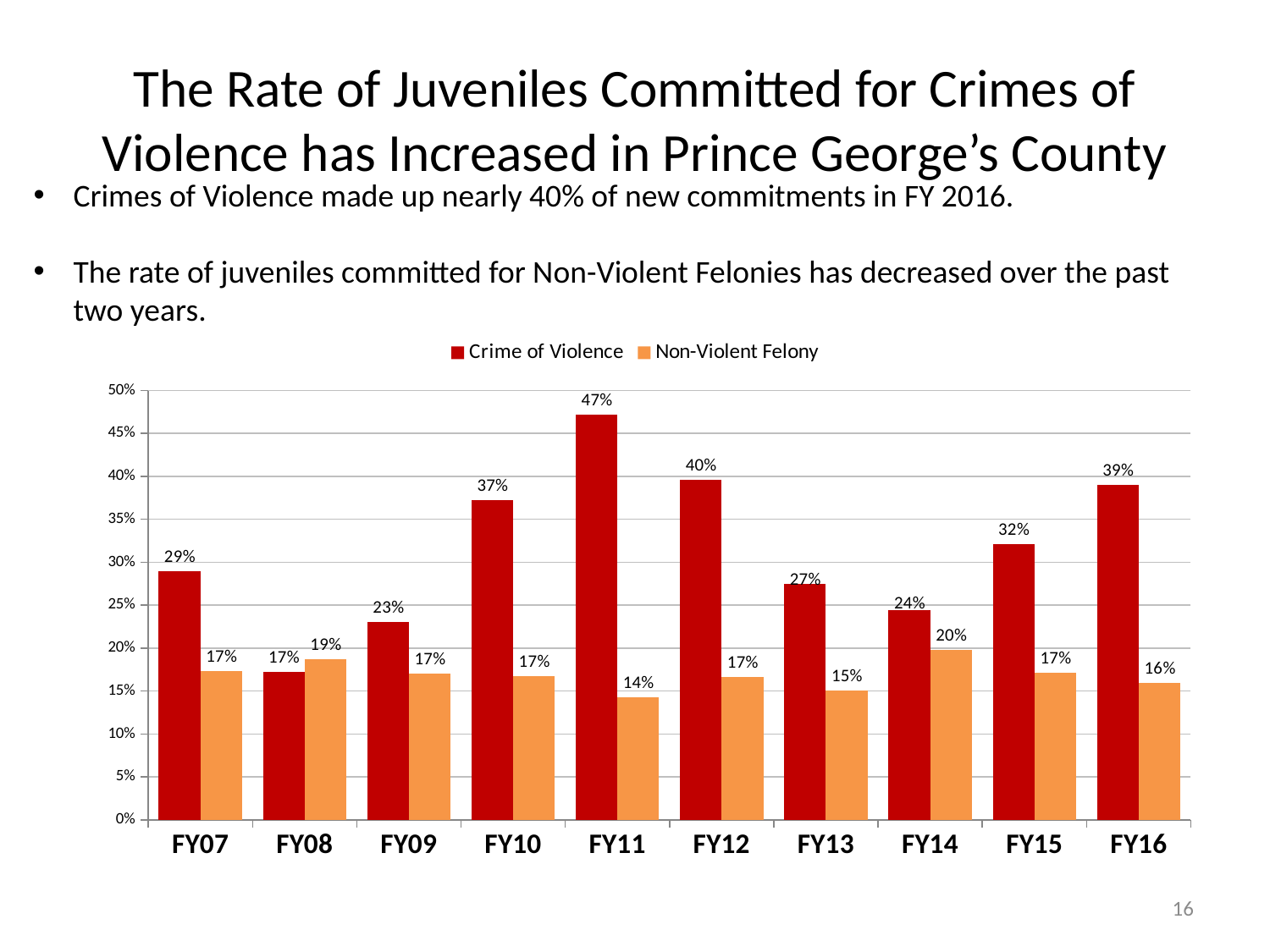
Which fiscal year has the highest Crime of Violence value? FY11 Which fiscal year has the lowest Non-Violent Felony value? FY11 What is the difference between the Crime of Violence and Non-Violent Felony values in FY16? 23% How many fiscal years are shown on the x axis? 10 Which series is shown in orange in the legend? Non-Violent Felony What kind of chart is shown on the slide? Bar chart Is the Crime of Violence value for FY15 greater or less than 30%? greater Which is larger in FY08: the Crime of Violence value or the Non-Violent Felony value? Non-Violent Felony What is the Crime of Violence value for FY11? 47% How many series does the legend list? 2 What is the Non-Violent Felony value for FY14? 20% What is the Crime of Violence value for FY16? 39%